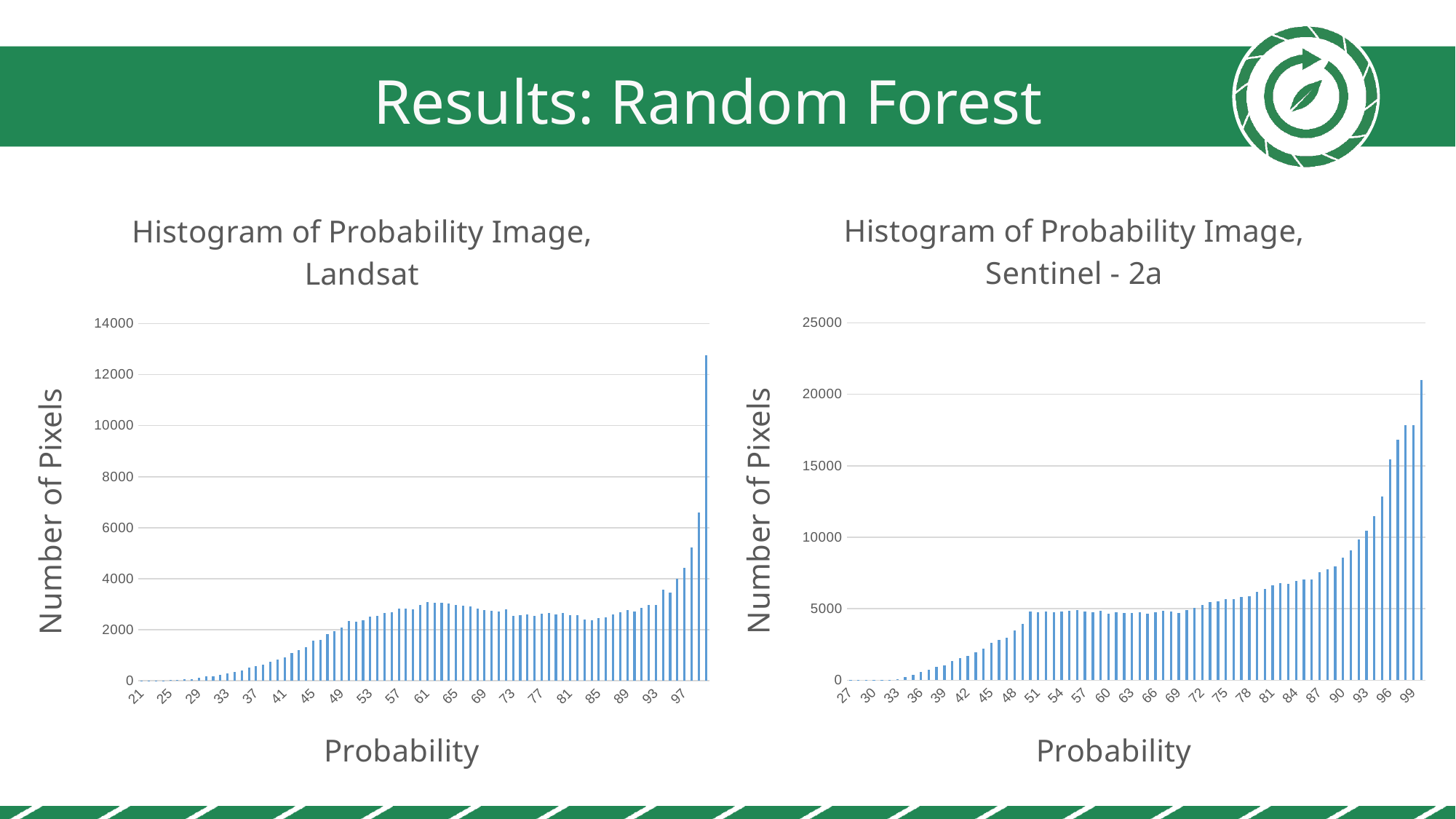
In the Sentinel - 2a histogram, do the values generally rise or fall as probability increases? rise What is the y-axis label on the Landsat histogram? Number of Pixels In the Landsat histogram, is the value at probability 41 greater or less than 2000? less In the Sentinel - 2a histogram, which has more pixels: probability 90 or probability 45? 90 In the Landsat histogram, is the value at probability 61 greater or less than 2000? greater In the Landsat histogram, is the value at probability 61 greater or less than 4000? less In the Landsat histogram, which has more pixels: probability 61 or probability 41? 61 What kind of chart is the Histogram of Probability Image, Sentinel - 2a? bar chart What kind of chart is the Histogram of Probability Image, Landsat? bar chart